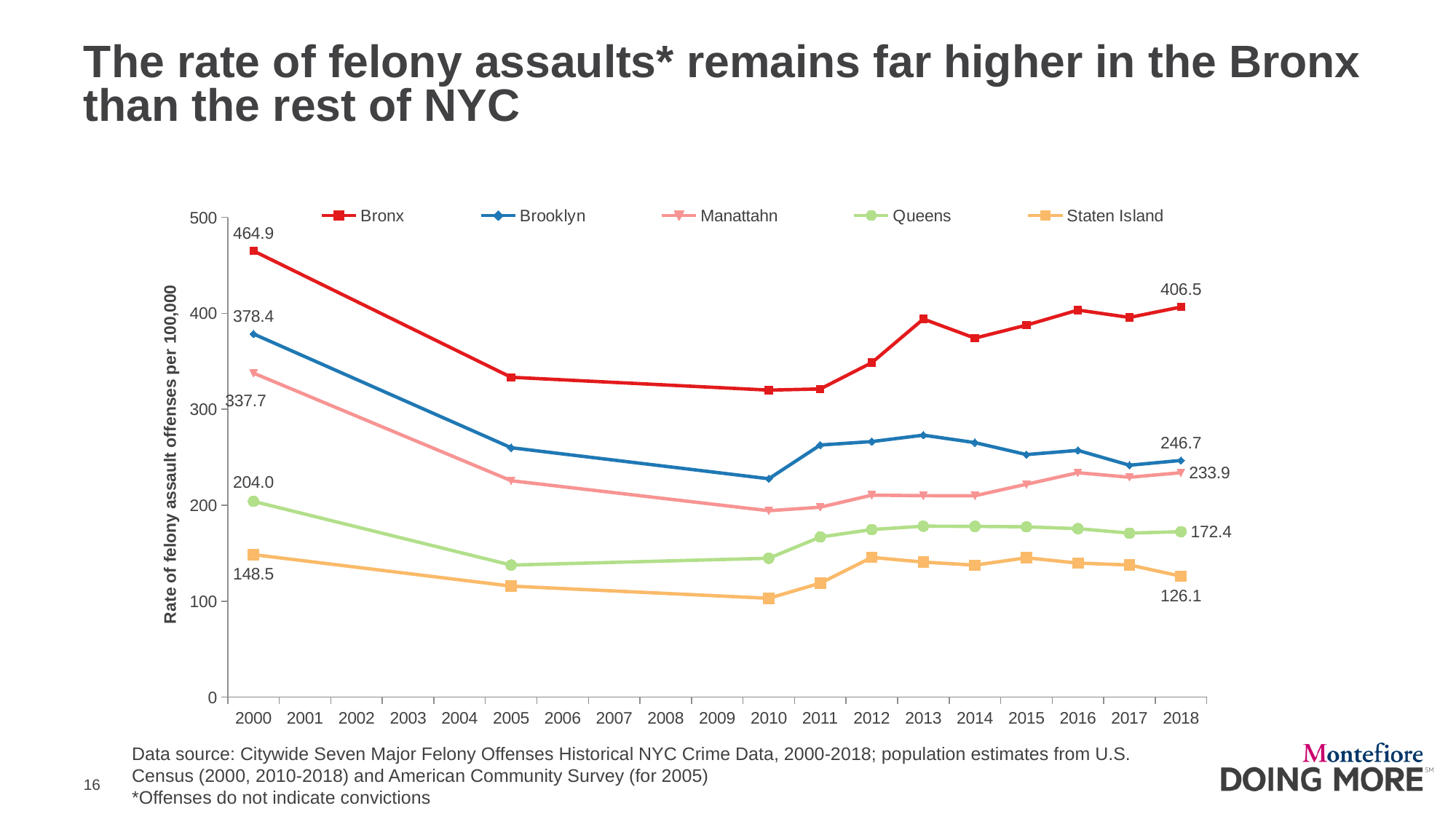
Which borough had the lowest felony assault rate in 2000? Staten Island Which borough had the highest felony assault rate in 2018? Bronx By how much did the Brooklyn felony assault rate fall from 2000 to 2018? 131.7 What was the Bronx felony assault rate per 100,000 in 2000? 464.9 What was the Queens felony assault rate per 100,000 in 2000? 204.0 Is the Bronx value for 2010 greater or less than 400? less How many series does the legend list? 5 Did the Bronx felony assault rate rise or fall between 2000 and 2005? fall What was the Bronx felony assault rate per 100,000 in 2018? 406.5 Which was higher in 2018, the Brooklyn rate or the Manhattan rate? Brooklyn What was the Staten Island felony assault rate per 100,000 in 2018? 126.1 What type of chart is shown on the slide? line chart